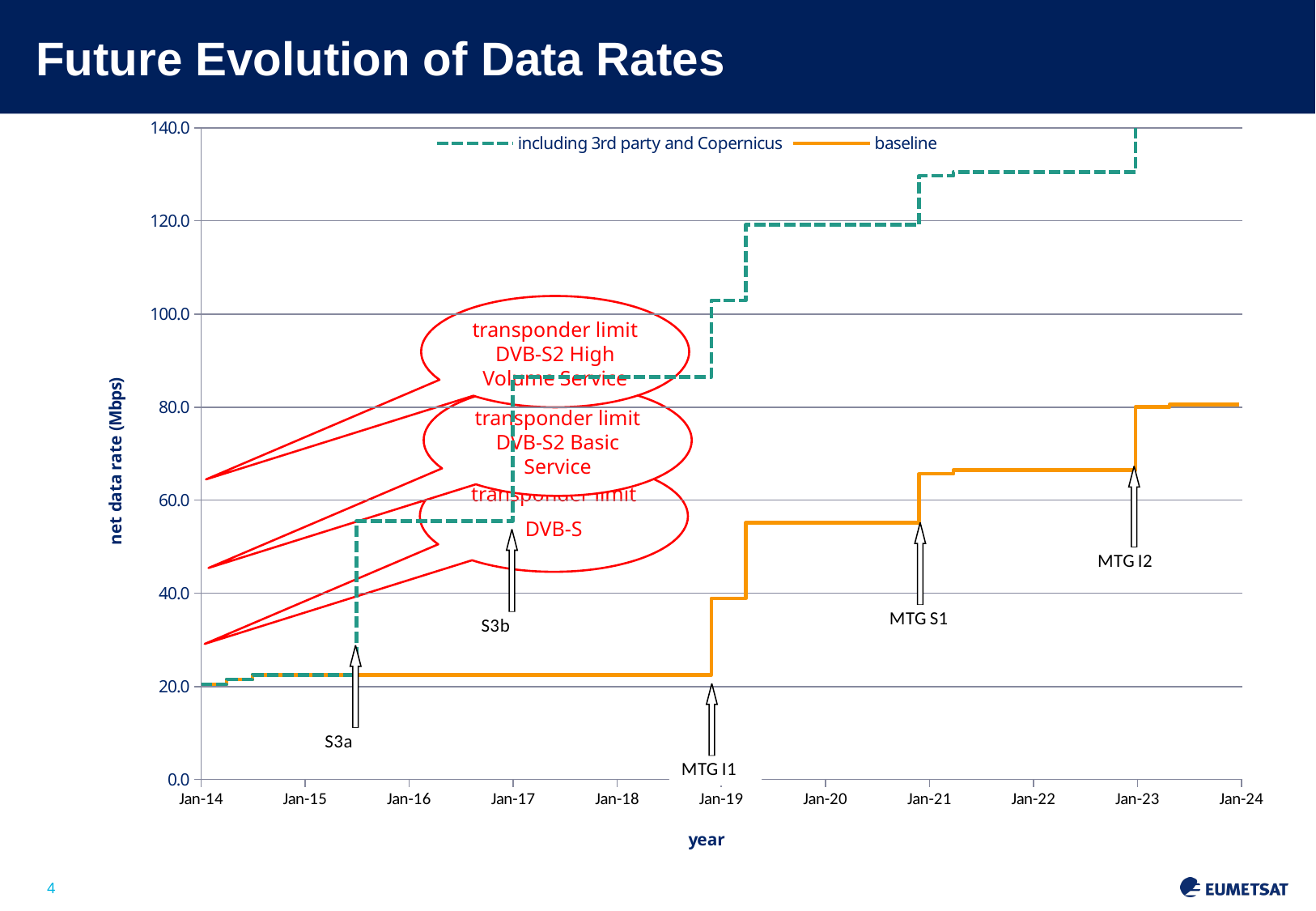
Is the value of the baseline series at Jan-20 greater or less than 40? greater At Jan-22, which series has the higher value, 'including 3rd party and Copernicus' or 'baseline'? including 3rd party and Copernicus Do the values of the baseline series rise or fall from Jan-14 to Jan-24? rise What are the two series named in the legend? including 3rd party and Copernicus; baseline How many series does the legend list? 2 What is the label of the vertical axis? net data rate (Mbps) Is the value of the baseline series at Jan-22 greater or less than 80? less Is the value of the 'including 3rd party and Copernicus' series at Jan-22 greater or less than 120? greater How many year labels are shown along the x axis? 11 What kind of chart is shown on the slide? line chart